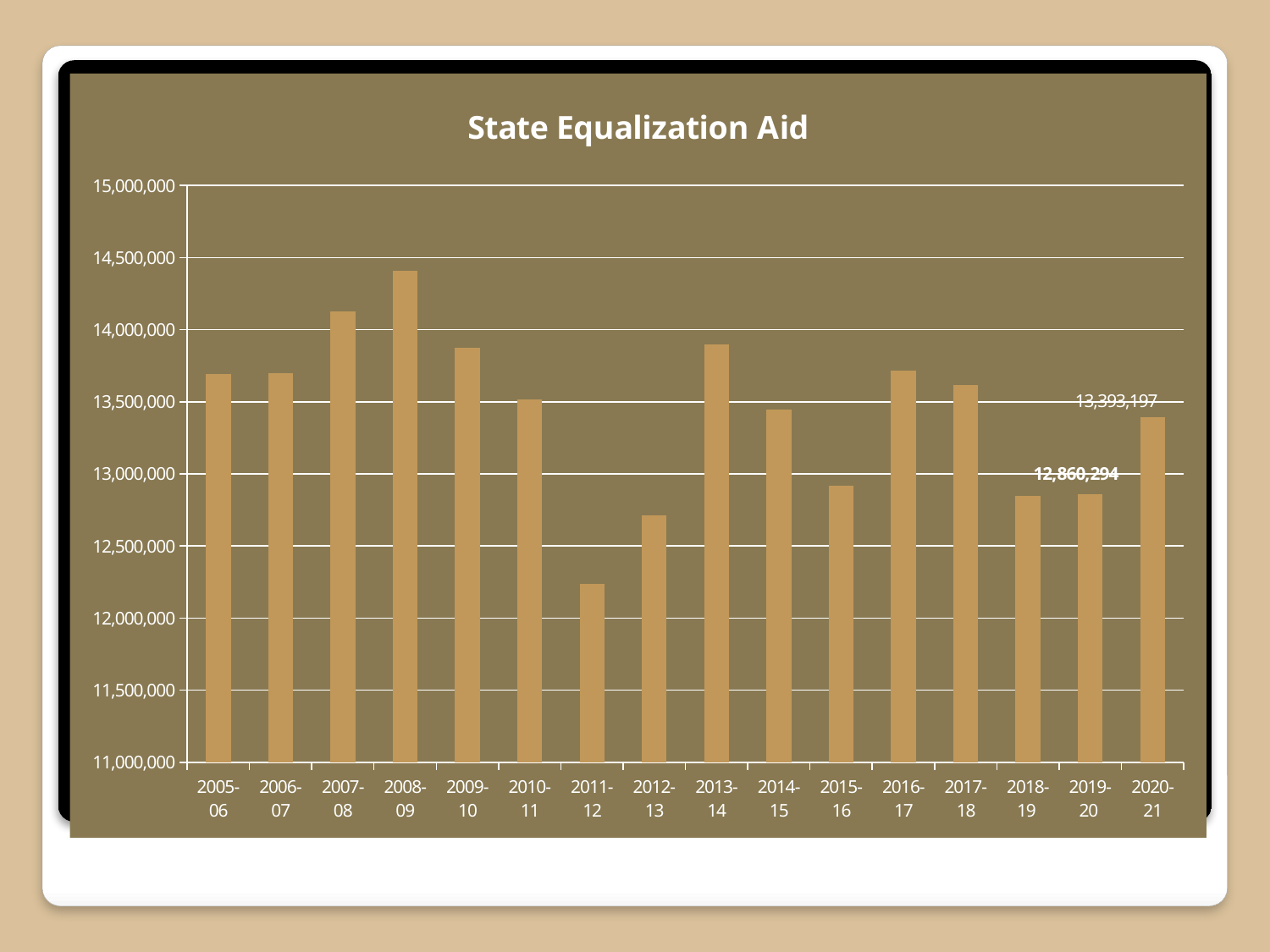
Which is larger, the value for 2007-08 or the value for 2009-10? 2007-08 What is the State Equalization Aid value labeled for 2020-21? 13,393,197 Which school year has the highest State Equalization Aid? 2008-09 Which school year has the lowest State Equalization Aid? 2011-12 What kind of chart is shown on the slide? bar chart How many school years are shown on the x axis of the chart? 16 What is the State Equalization Aid value labeled for 2019-20? 12,860,294 Is the value for 2011-12 greater or less than 12,500,000? less What is the difference between the labeled values for 2020-21 and 2019-20? 532,903 Is the value for 2008-09 greater or less than 14,000,000? greater Do the values rise or fall from 2008-09 to 2011-12? fall What is the title of the chart? State Equalization Aid